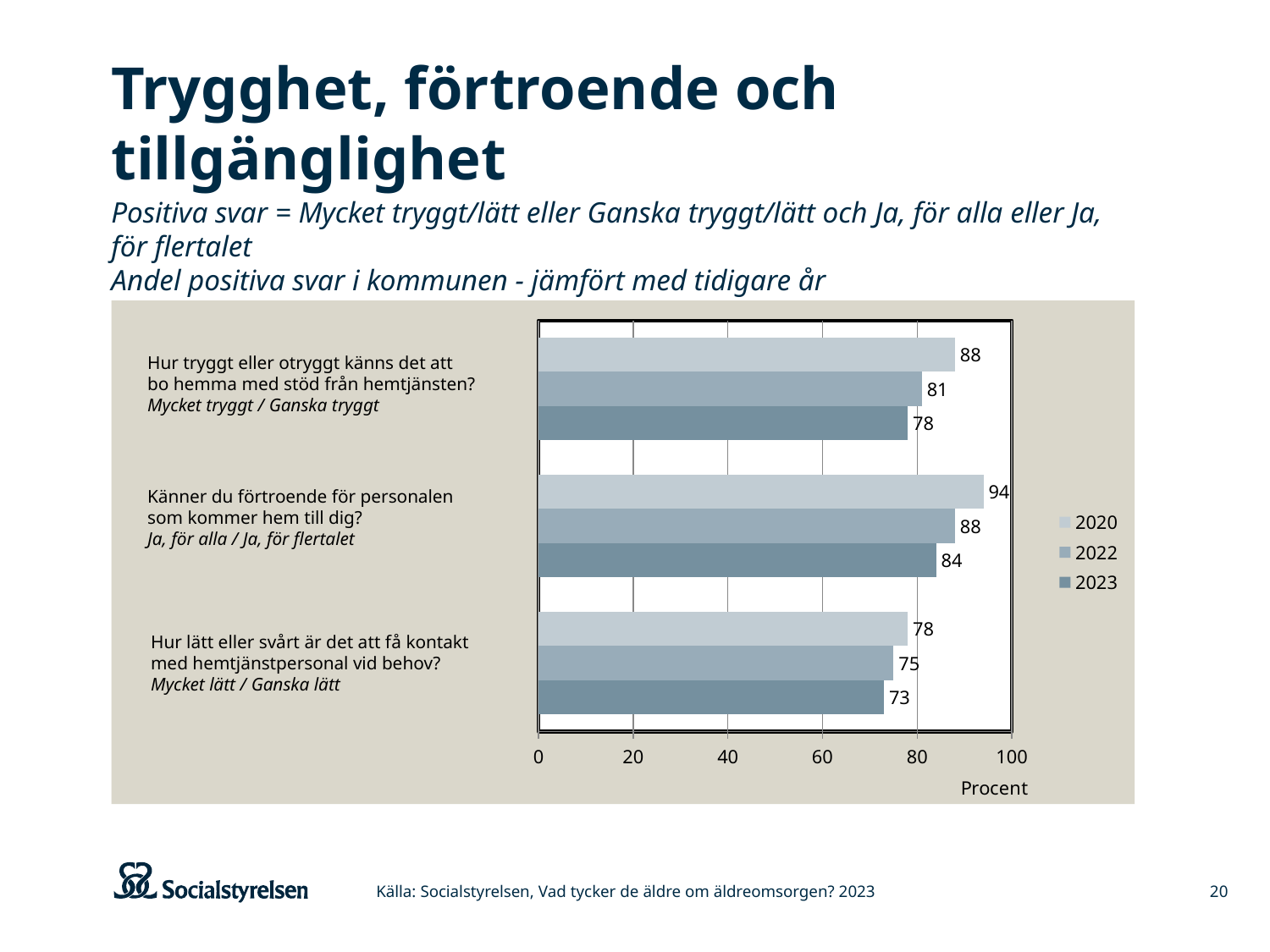
Which question has the highest 2023 value? Känner du förtroende för personalen som kommer hem till dig? What is the label of the horizontal axis? Procent What is the 2022 value for "Hur tryggt eller otryggt känns det att bo hemma med stöd från hemtjänsten?"? 81 What is the 2020 value for "Känner du förtroende för personalen som kommer hem till dig?"? 94 What is the difference between the 2020 and 2023 values for "Hur tryggt eller otryggt känns det att bo hemma med stöd från hemtjänsten?"? 10 What kind of chart is shown on the slide? Bar chart Which is larger: the 2022 value for "Känner du förtroende för personalen som kommer hem till dig?" or the 2020 value for "Hur tryggt eller otryggt känns det att bo hemma med stöd från hemtjänsten?"? They are equal (88) Which question has the lowest 2020 value? Hur lätt eller svårt är det att få kontakt med hemtjänstpersonal vid behov? What is the 2023 value for "Hur lätt eller svårt är det att få kontakt med hemtjänstpersonal vid behov?"? 73 Is the 2023 value for "Känner du förtroende för personalen som kommer hem till dig?" greater or less than 80? greater How many question categories are shown in the chart? 3 How many series does the legend list? 3